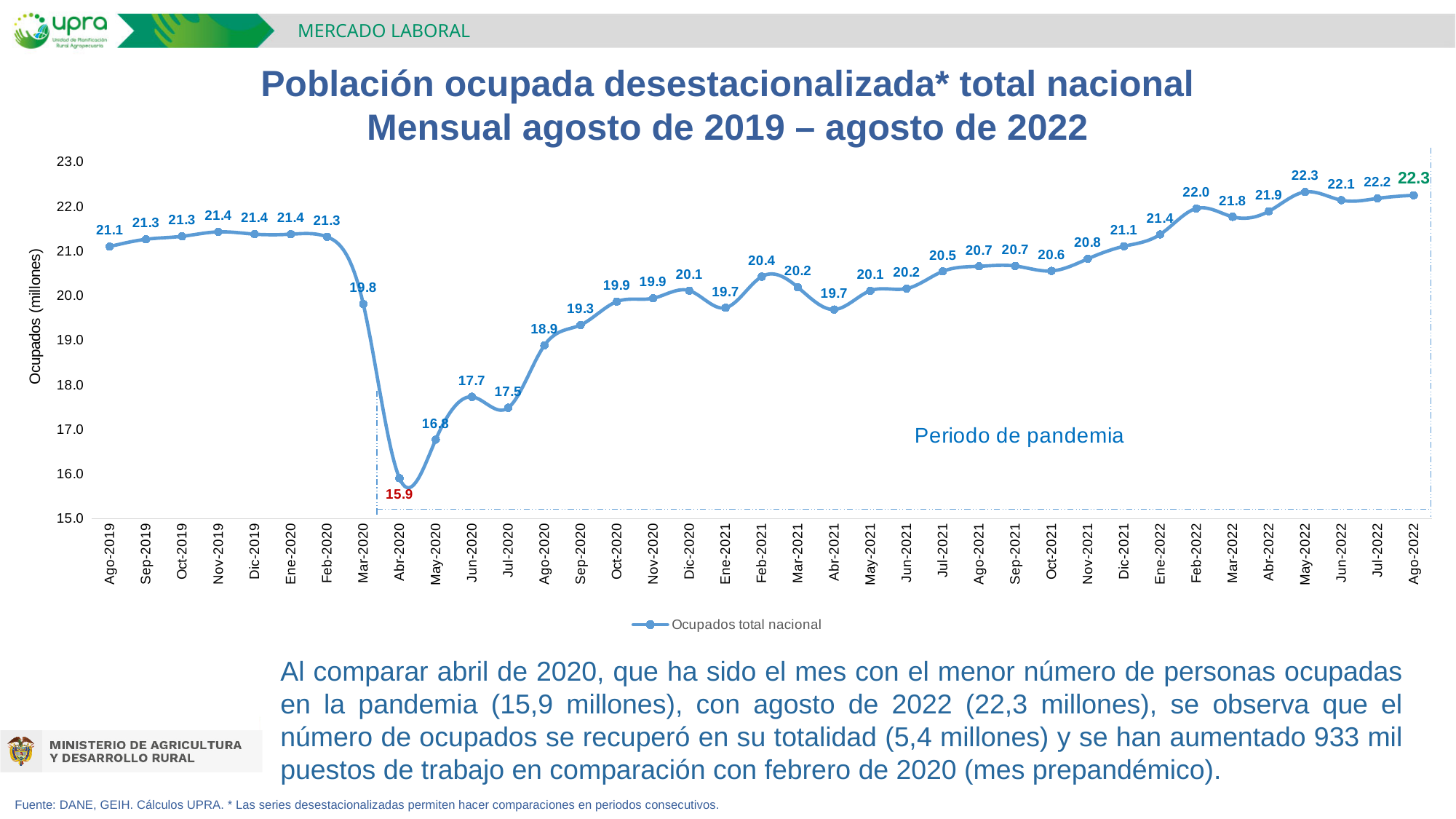
What is the name of the series shown in the legend? Ocupados total nacional What is the value for Ago-2022? 22.3 Is the value for Jun-2020 greater or less than 18.0? less How many monthly data points are plotted? 37 Which is larger, the value for Feb-2022 or the value for Mar-2022? Feb-2022 What is the value for Mar-2020? 19.8 What is the value for Abr-2020? 15.9 How many series does the legend list? 1 What kind of chart is shown on the slide? line chart What is the difference between the values for Ago-2022 and Abr-2020? 6.4 What is the value for Feb-2020? 21.3 Which month has the lowest value? Abr-2020